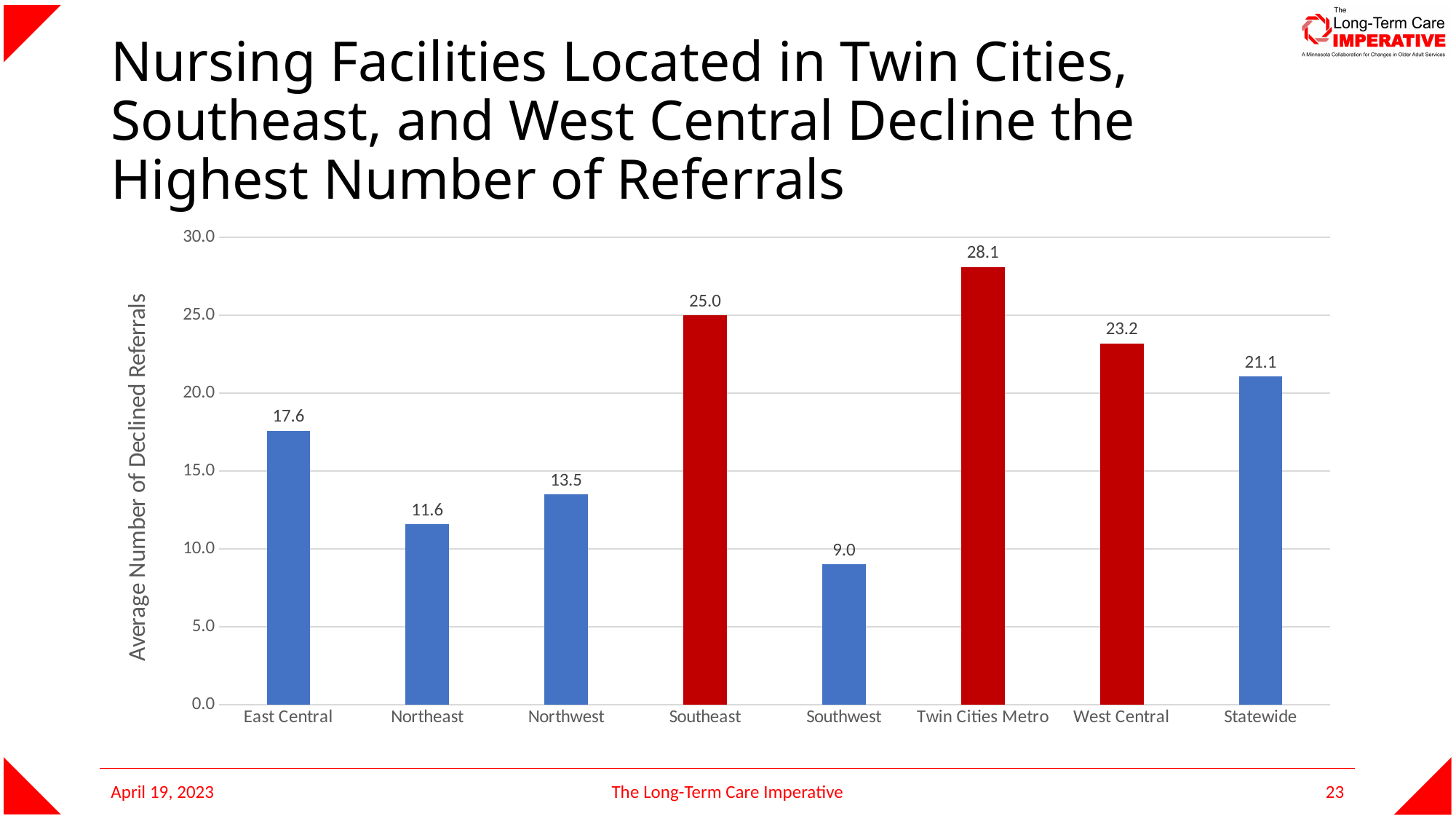
What is the difference between the Southeast and Northeast values? 13.4 Is the value for West Central greater or less than 20.0? greater Which region has the highest average number of declined referrals? Twin Cities Metro How many categories are shown on the x axis? 8 What is the Statewide average number of declined referrals? 21.1 Which region has the lowest average number of declined referrals? Southwest Which regions' bars are coloured red? Southeast, Twin Cities Metro, West Central What is the average number of declined referrals for Twin Cities Metro? 28.1 What is the label of the vertical axis? Average Number of Declined Referrals Which is larger, the value for East Central or the value for Northwest? East Central What is the average number of declined referrals for Southwest? 9.0 What kind of chart is shown on the slide? Bar chart